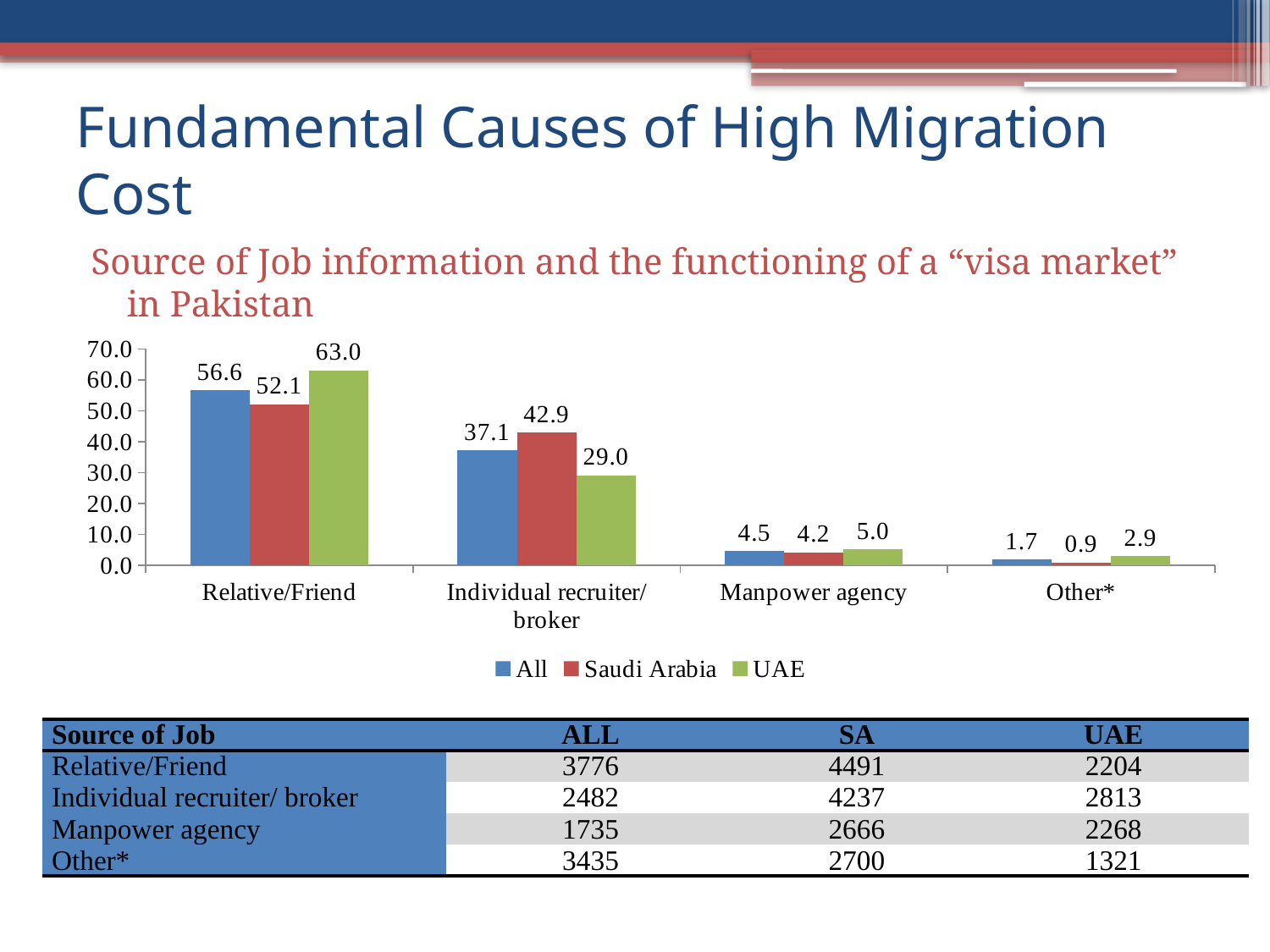
Is the value for Saudi Arabia in the Relative/Friend category greater or less than 50.0? greater Which is larger in the Individual recruiter/ broker category, the All value or the UAE value? All What is the difference between the UAE and Saudi Arabia values in the Relative/Friend category? 10.9 What kind of chart is shown on the slide? Bar chart What is the value for Saudi Arabia in the Individual recruiter/ broker category? 42.9 How many series does the chart legend list? 3 Which series is shown in green in the chart legend? UAE Which category has the highest value for the All series? Relative/Friend How many categories are shown on the x axis of the chart? 4 What is the value for All in the Manpower agency category? 4.5 Which category has the lowest value for the Saudi Arabia series? Other* What is the value for UAE in the Relative/Friend category? 63.0